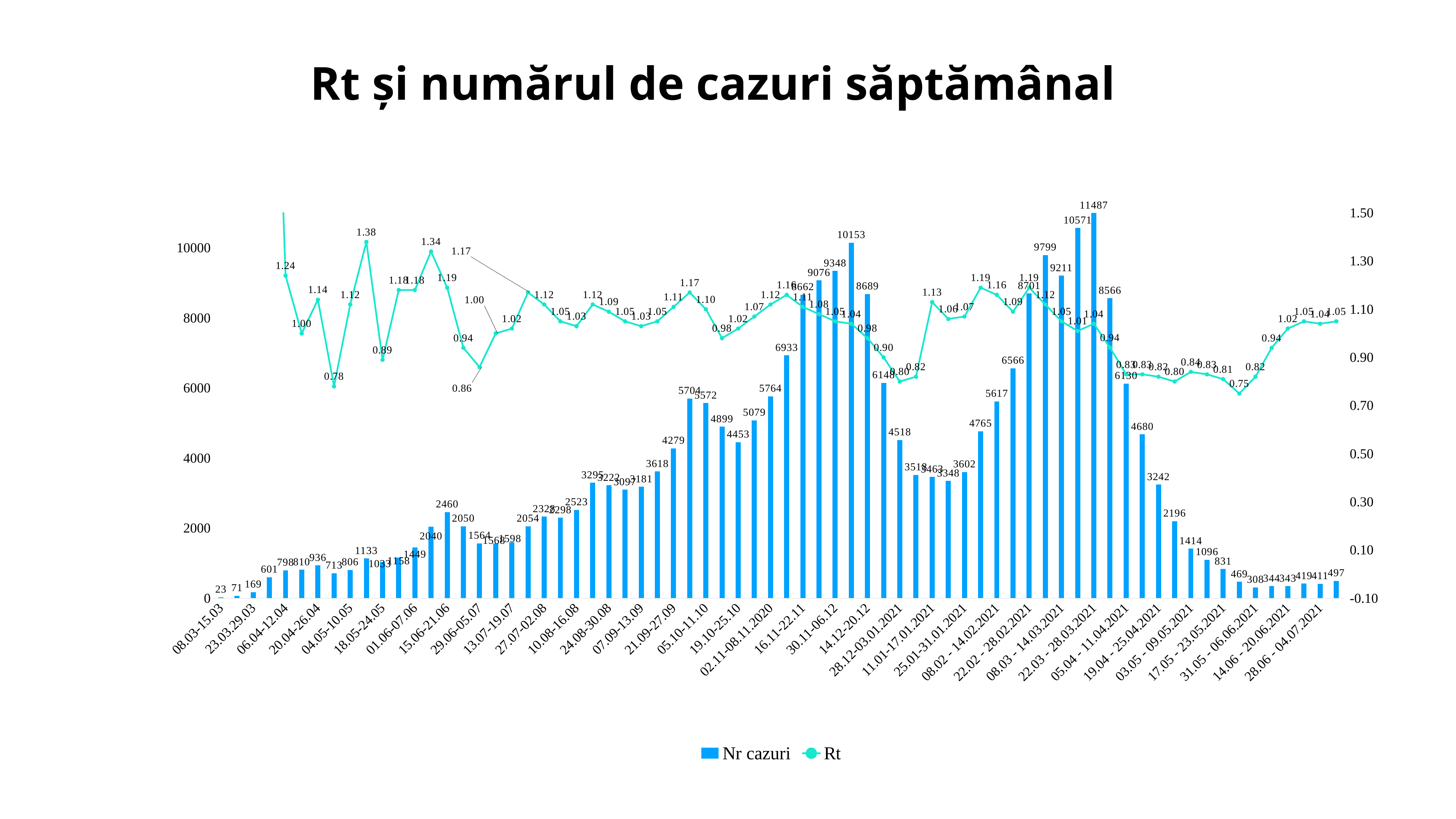
What is the lowest weekly number of cases (Nr cazuri) shown on the chart? 23 What kind of chart is shown on the slide? Combined bar and line chart What is the lowest Rt value labelled on the chart? 0.75 What is the difference between the two highest weekly case counts, 11487 and 10571? 916 What is the highest Rt value labelled on the chart? 1.38 What is the number of cases for the week 08.03-15.03? 23 What is the title of the chart? Rt și numărul de cazuri săptămânal What is the number of cases for the week 28.06 - 04.07.2021? 411 What is the highest weekly number of cases (Nr cazuri) shown on the chart? 11487 How many series does the legend list? 2 Which is larger, the weekly case peak of 10153 or the peak of 9799? 10153 Is the number of cases for the week 28.06 - 04.07.2021 greater or less than 2000? less